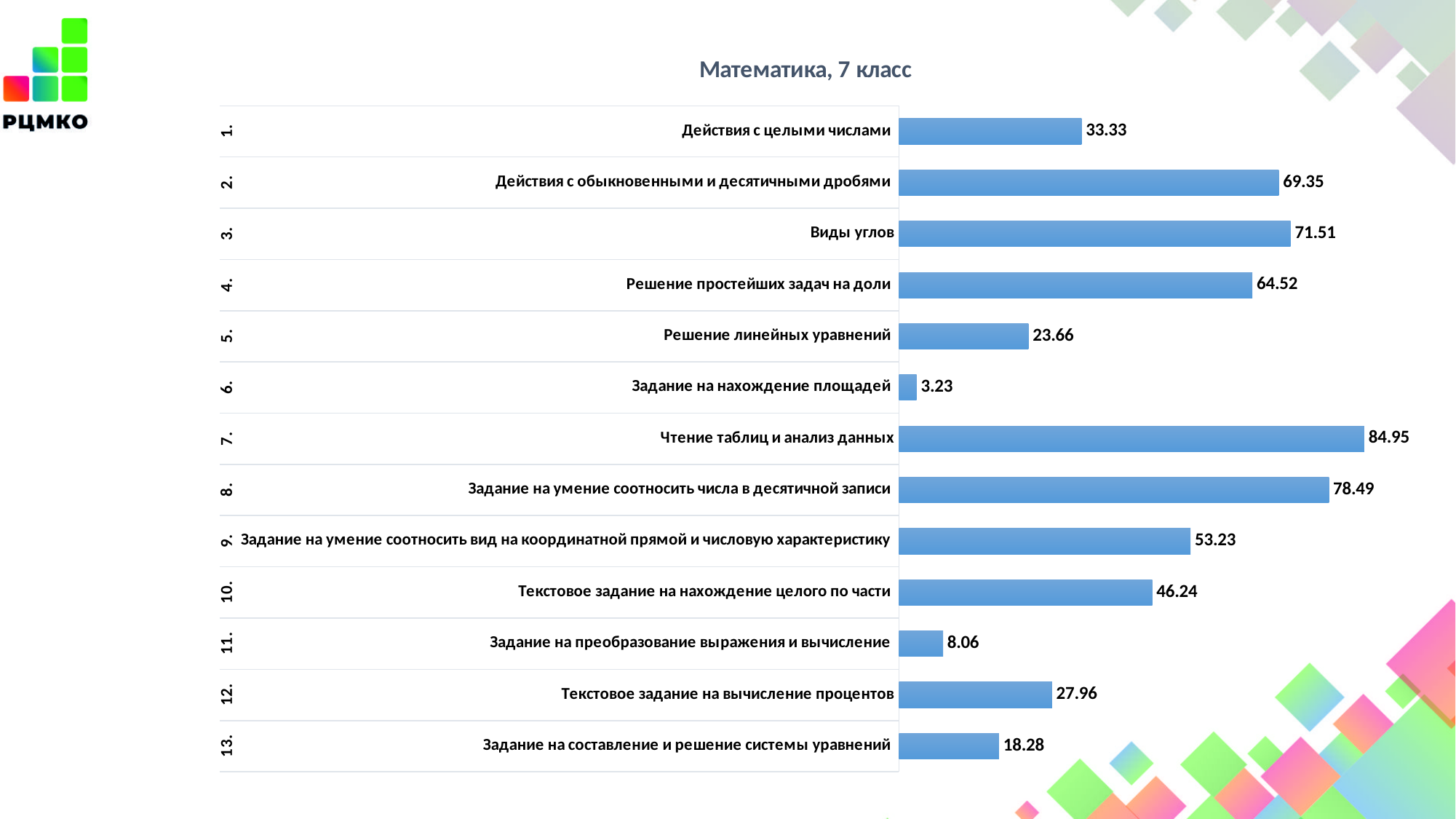
What is the value for "Задание на составление и решение системы уравнений"? 18.28 What is the value for "Виды углов"? 71.51 What is the value for "Решение линейных уравнений"? 23.66 What kind of chart is shown on the slide? Bar chart Which category has the highest value? Чтение таблиц и анализ данных How many categories are shown in the chart? 13 What is the difference between the values for "Виды углов" and "Действия с обыкновенными и десятичными дробями"? 2.16 Which category has the lowest value? Задание на нахождение площадей What is the title of the chart? Математика, 7 класс What is the value for "Чтение таблиц и анализ данных"? 84.95 What is the difference between the values for "Задание на умение соотносить числа в десятичной записи" and "Задание на преобразование выражения и вычисление"? 70.43 Which is larger: the value for "Текстовое задание на вычисление процентов" or the value for "Действия с целыми числами"? Действия с целыми числами